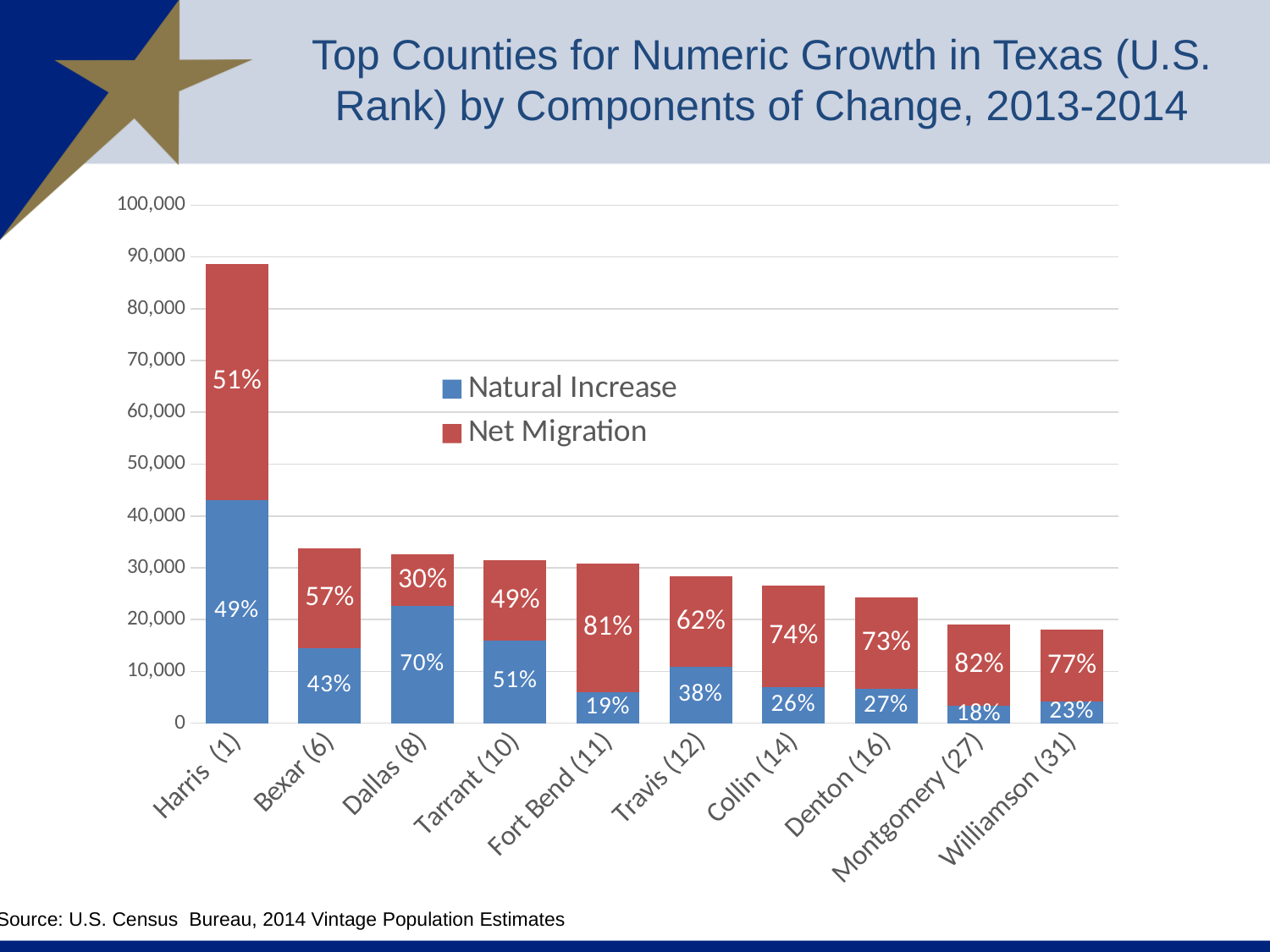
How many series does the chart's legend list? 2 Which county has the highest Net Migration percentage label? Montgomery (27) Which county has the tallest bar (largest total numeric growth)? Harris (1) Is the total bar height for Williamson (31) greater or less than 20,000? less What percentage label is shown for Natural Increase in Dallas (8)? 70% Which county has the lowest Natural Increase percentage label? Montgomery (27) Is the total bar height for Harris (1) greater or less than 80,000? greater For Dallas (8), which component has the larger percentage, Natural Increase or Net Migration? Natural Increase Do the total bar heights rise or fall moving from left to right across the counties? fall What percentage label is shown for Net Migration in Fort Bend (11)? 81% How many counties are shown on the x axis of the chart? 10 What kind of chart is shown on the slide? Stacked bar chart